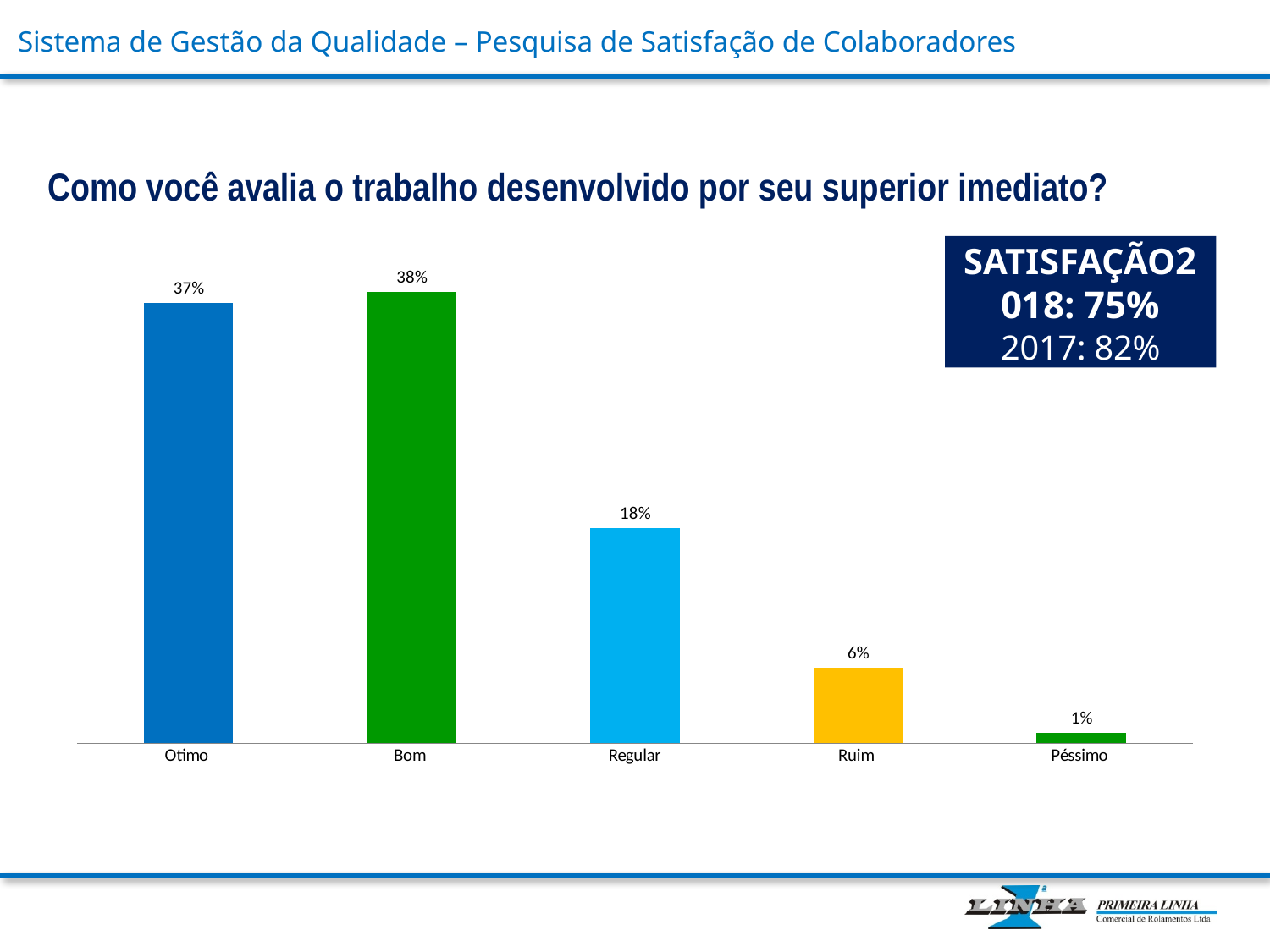
What is the difference between the values for Bom and Regular? 20% What is the difference between the values for Regular and Ruim? 12% Which category has the lowest value? Péssimo Which is larger, the value for Regular or the value for Ruim? Regular What is the value for Bom? 38% What is the value for Ruim? 6% How many categories are shown on the chart? 5 What kind of chart is shown on the slide? Bar chart What is the value for Péssimo? 1% What colour is the bar for Ruim? Yellow What is the value for Otimo? 37% What is the value for Regular? 18%